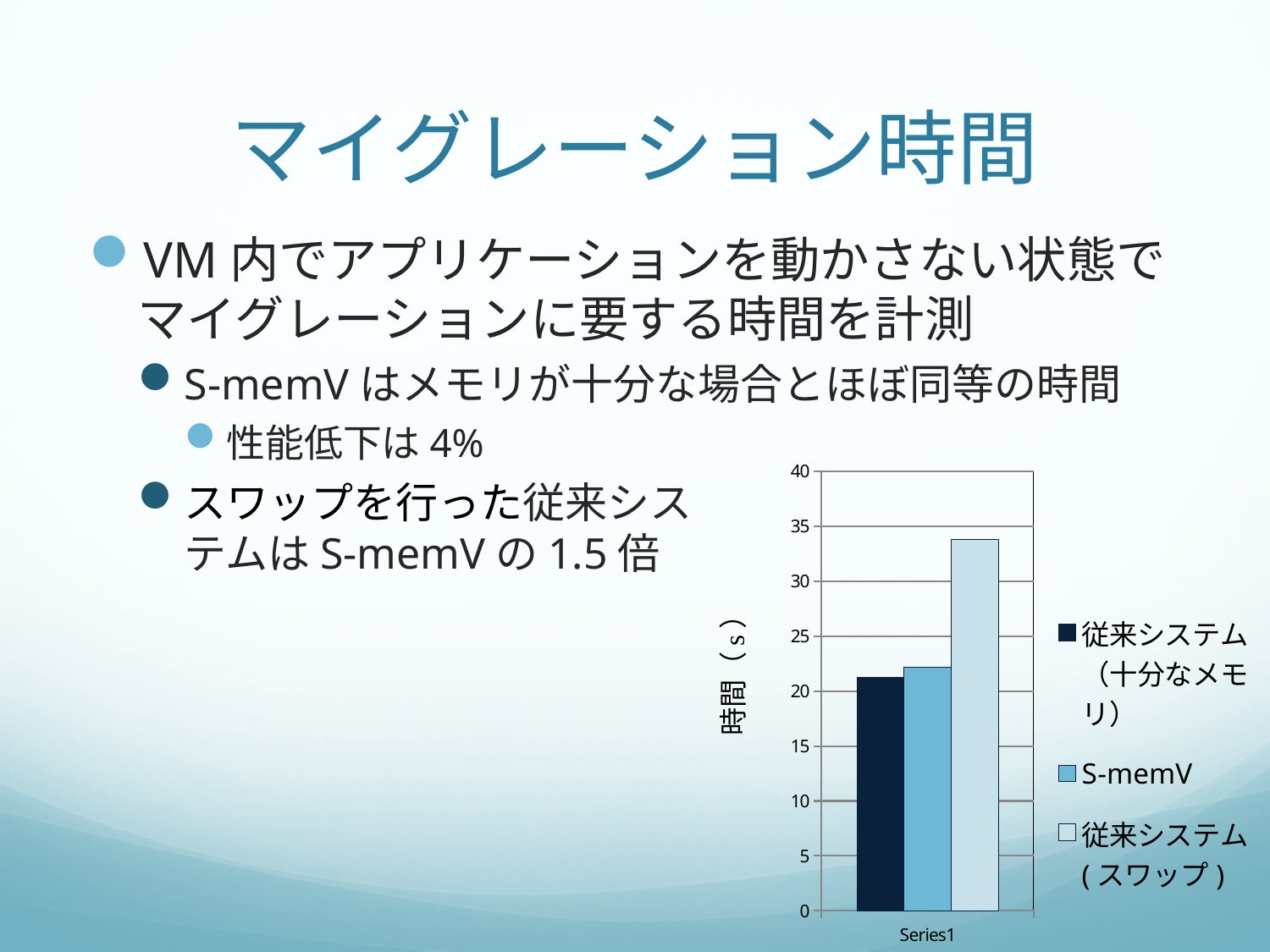
Which is larger, the value for S-memV or the value for 従来システム(スワップ)? 従来システム(スワップ) What kind of chart is shown on the slide? bar chart Is the value for 従来システム(スワップ) greater or less than 35? less Is the value for 従来システム（十分なメモリ） greater or less than 25? less What is the category label shown on the x axis of the chart? Series1 Which series has the highest value in the chart? 従来システム(スワップ) How many series does the chart legend list? 3 Is the value for S-memV greater or less than 20? greater How many categories are shown on the x axis of the chart? 1 What is the label of the y axis of the chart? 時間（s）